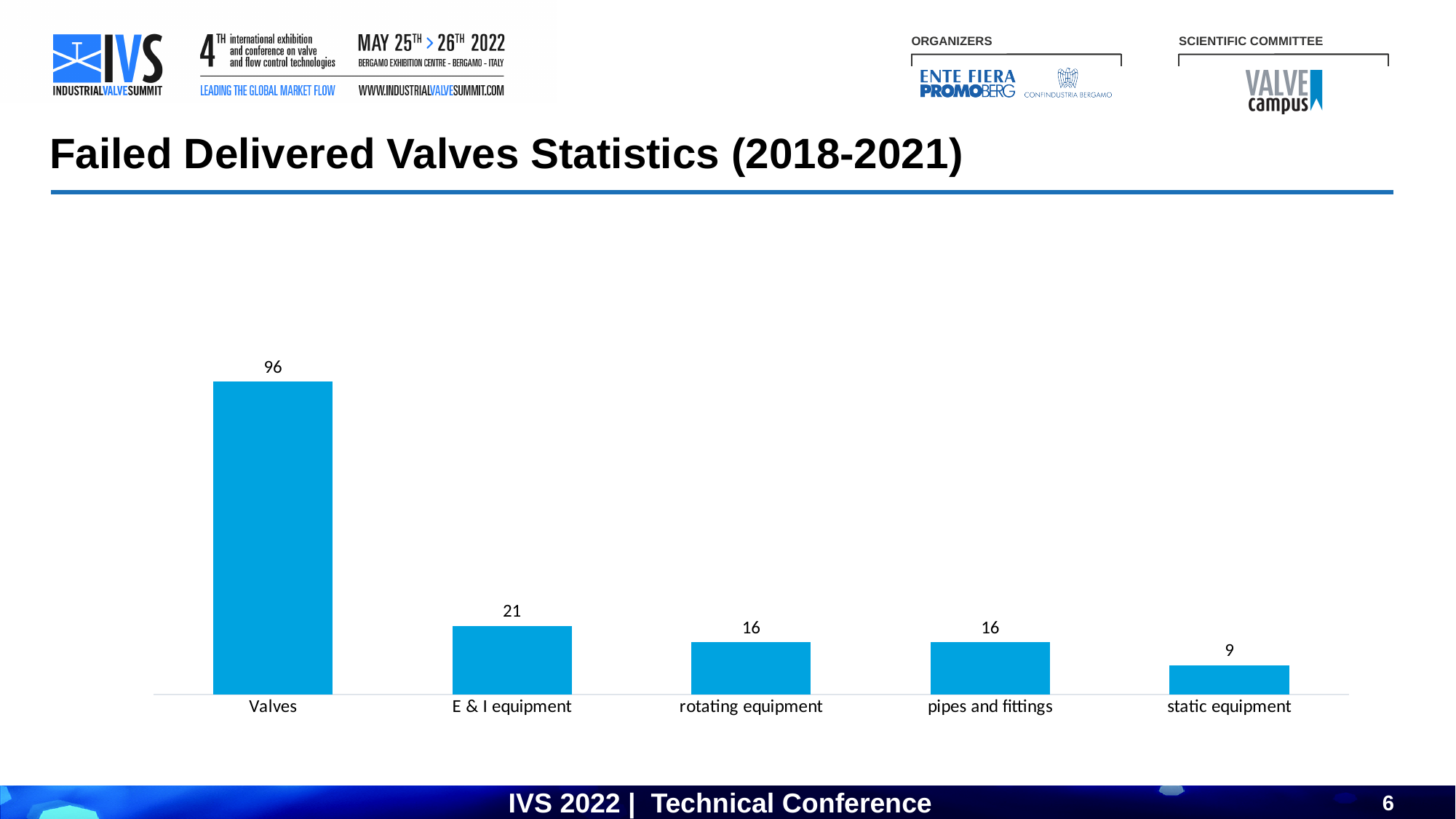
What is the value for Valves? 96 What is the difference between the values for pipes and fittings and static equipment? 7 How many categories are shown in the chart? 5 What is the difference between the values for Valves and E & I equipment? 75 What kind of chart is shown on the slide? bar chart Which category has the highest value? Valves What is the value for static equipment? 9 Which is larger, the value for E & I equipment or the value for rotating equipment? E & I equipment What is the title of the slide containing the chart? Failed Delivered Valves Statistics (2018-2021) Which category has the lowest value? static equipment What is the value for rotating equipment? 16 What is the value for E & I equipment? 21